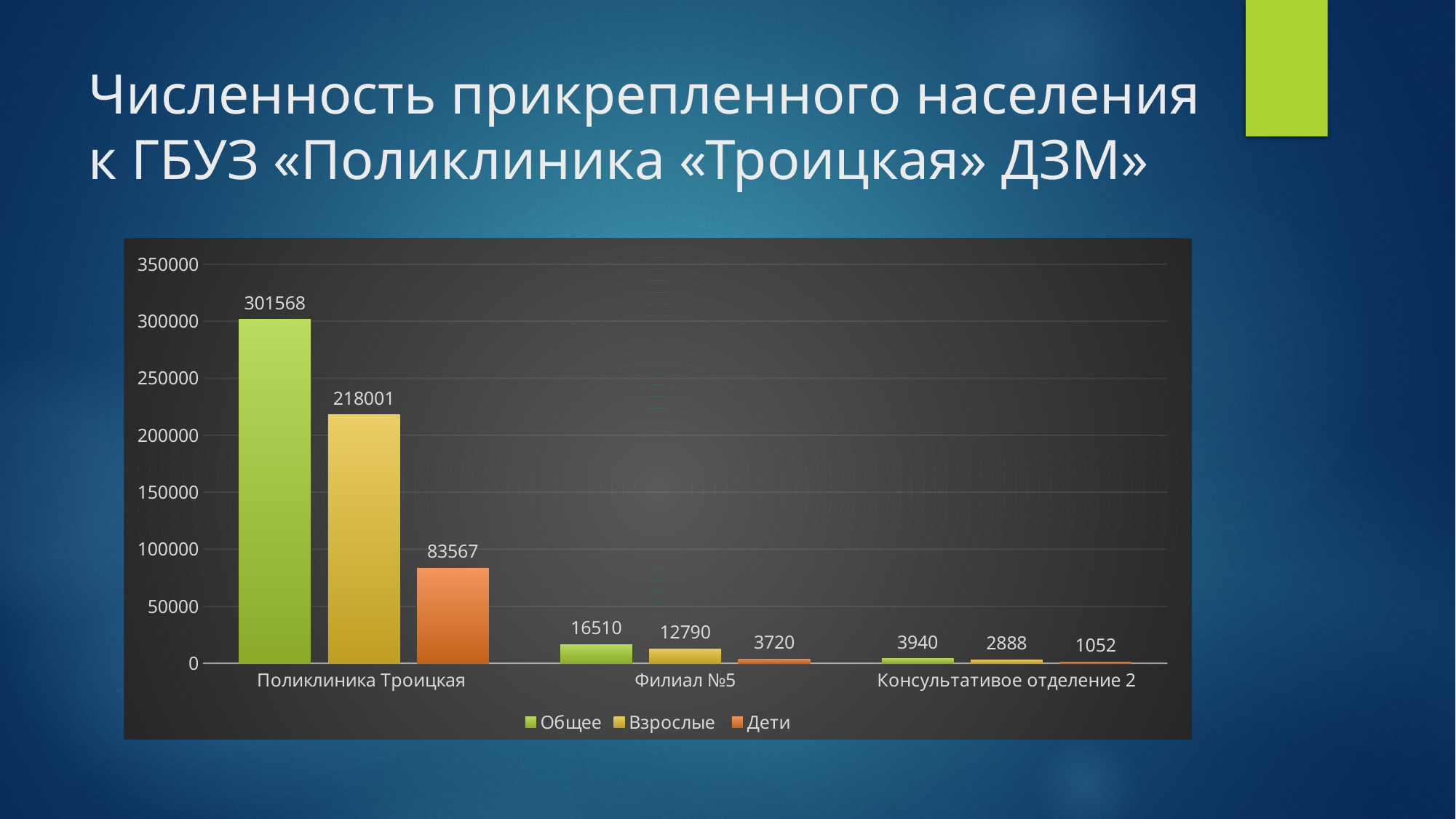
Which colour represents the Дети series in the legend? orange What is the value of Взрослые for Филиал №5? 12790 What is the difference between Взрослые and Дети for Поликлиника Троицкая? 134434 Which category has the highest Общее value? Поликлиника Троицкая What is the value of Общее for Поликлиника Троицкая? 301568 How many categories are shown on the x axis? 3 What is the value of Дети for Консультативое отделение 2? 1052 Which is larger: Общее for Филиал №5 or Дети for Поликлиника Троицкая? Дети for Поликлиника Троицкая What kind of chart is shown on the slide? bar chart Is the Взрослые value for Поликлиника Троицкая greater or less than 200000? greater Which category has the lowest Дети value? Консультативое отделение 2 How many series does the legend list? 3